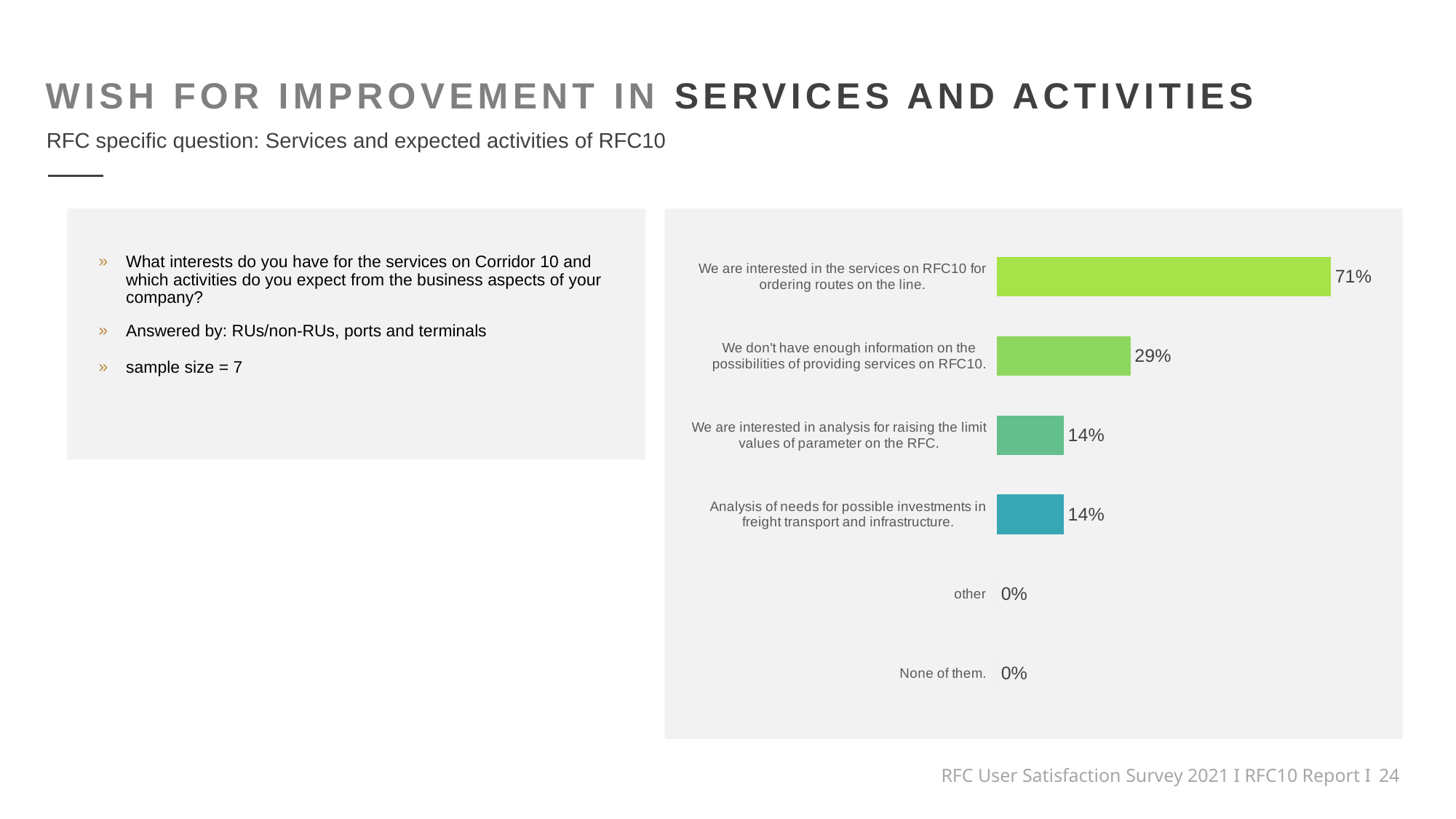
Which is larger: the percentage for "We don't have enough information on the possibilities of providing services on RFC10." or for "Analysis of needs for possible investments in freight transport and infrastructure."? We don't have enough information on the possibilities of providing services on RFC10. How many categories have a value of 0%? 2 What is the sample size stated on the slide? 7 What percentage is shown for "We are interested in analysis for raising the limit values of parameter on the RFC."? 14% How many categories are shown in the chart? 6 What kind of chart is shown on the slide? Bar chart What percentage is shown for "We don't have enough information on the possibilities of providing services on RFC10."? 29% Which category has the highest percentage? We are interested in the services on RFC10 for ordering routes on the line. What is the difference between the percentage for "We are interested in the services on RFC10 for ordering routes on the line." and "We don't have enough information on the possibilities of providing services on RFC10."? 42% What percentage is shown for "Analysis of needs for possible investments in freight transport and infrastructure."? 14% What percentage is shown for "None of them."? 0% What percentage is shown for "We are interested in the services on RFC10 for ordering routes on the line."? 71%